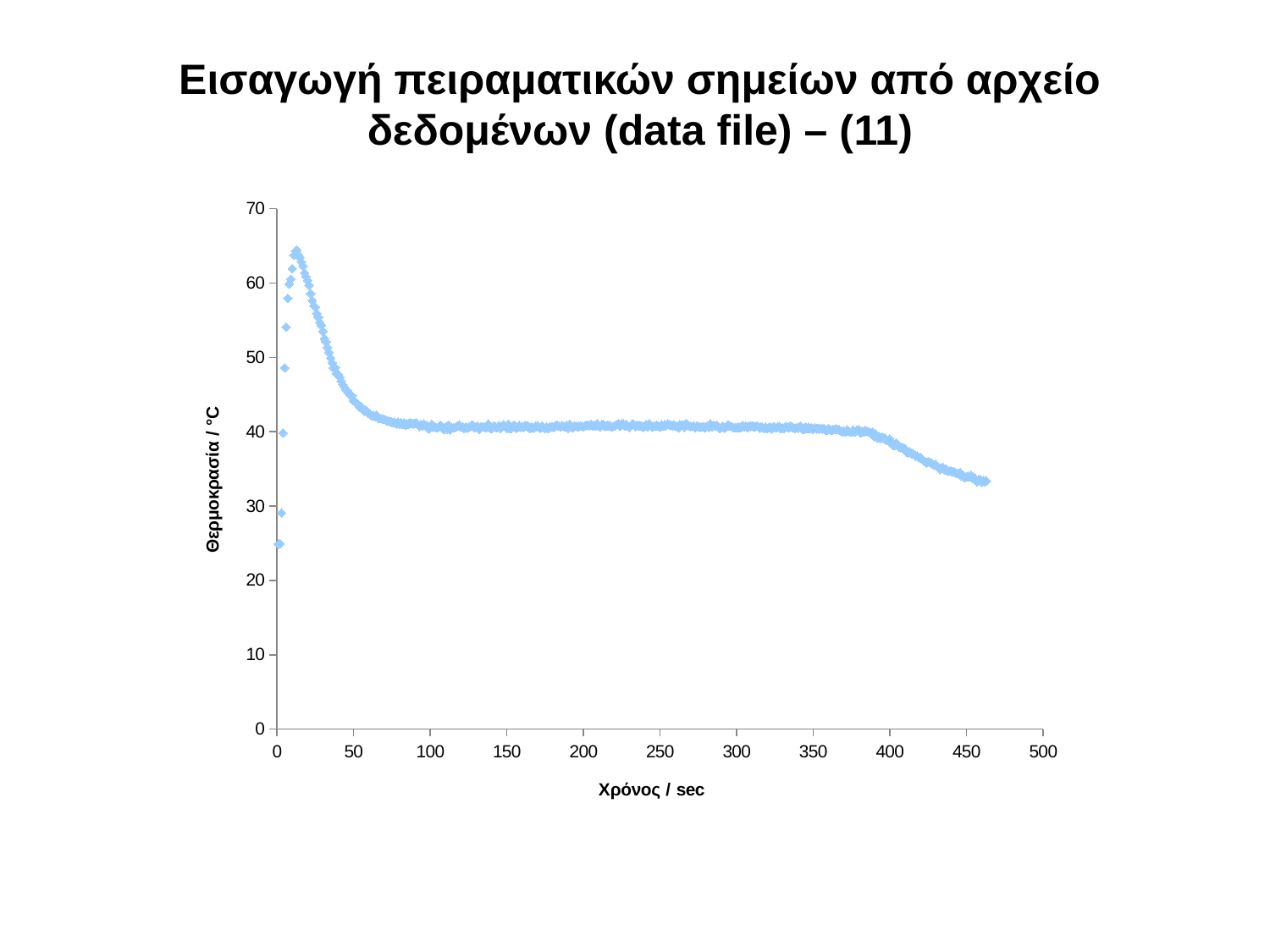
What is the title of the y axis of the chart? Θερμοκρασία / °C Is the highest temperature reached greater or less than 70? less Does the temperature rise or fall between 20 sec and 60 sec? fall Which is larger, the temperature at 10 sec or the temperature at 100 sec? the temperature at 10 sec Does the temperature rise or fall between 400 sec and 460 sec? fall Is the temperature at 200 sec greater or less than 30? greater What kind of chart is shown on the slide? scatter chart Is the temperature at 200 sec greater or less than 50? less What is the title of the x axis of the chart? Χρόνος / sec Which is larger, the temperature at 200 sec or the temperature at 450 sec? the temperature at 200 sec